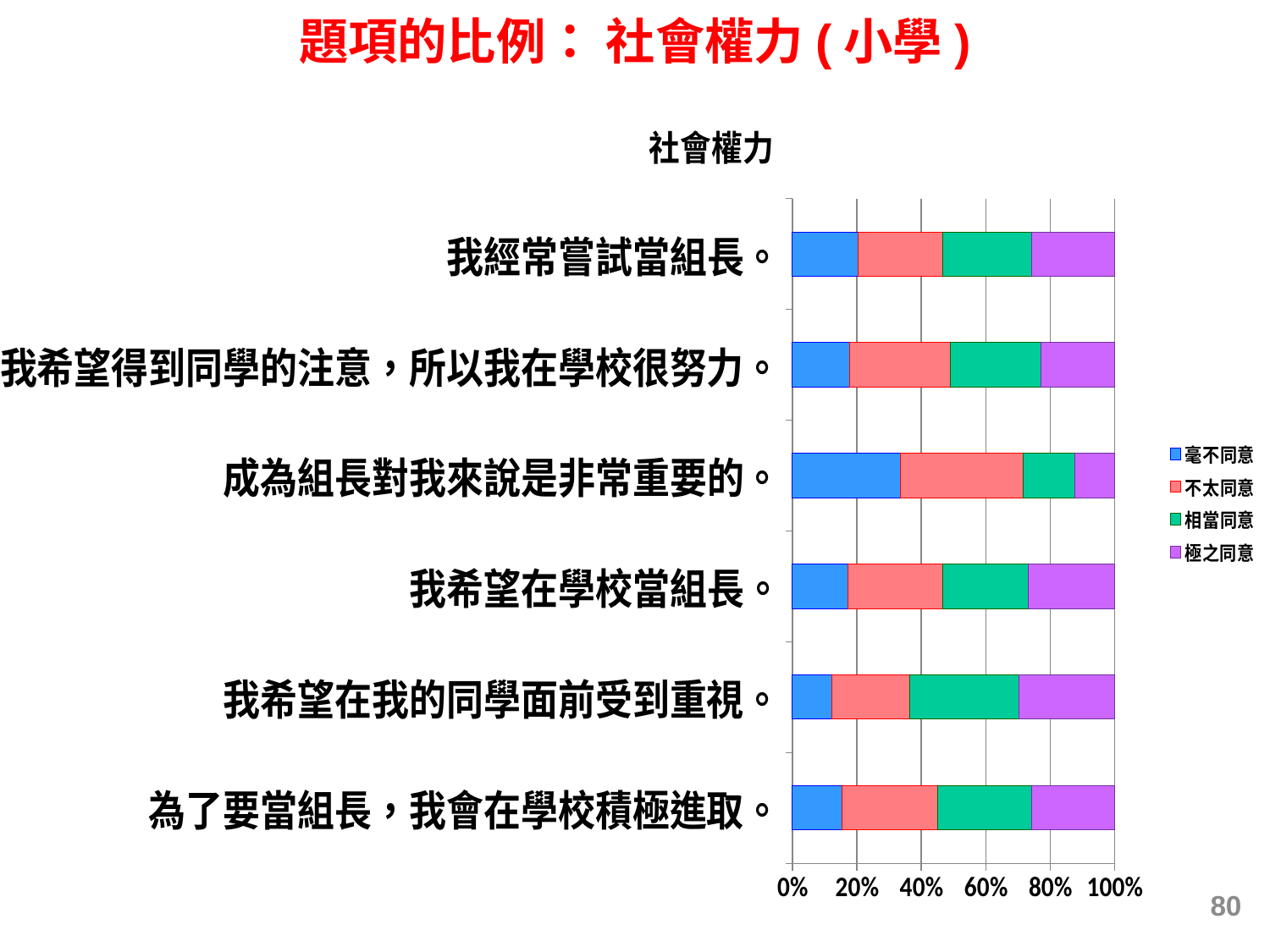
What is the title of the chart? 社會權力 Which has the larger 毫不同意 share: 成為組長對我來說是非常重要的。 or 我經常嘗試當組長。? 成為組長對我來說是非常重要的。 Which colour represents 相當同意 in the chart? Green What kind of chart is shown on the slide? Stacked bar chart Which statement has the smallest 極之同意 share? 成為組長對我來說是非常重要的。 What does each stacked bar total on the x axis? 100% Is the 毫不同意 share for 成為組長對我來說是非常重要的。 greater or less than 20%? greater Which statement has the largest 毫不同意 share? 成為組長對我來說是非常重要的。 Is the 毫不同意 share for 我希望在我的同學面前受到重視。 greater or less than 20%? less How many statements (categories) are plotted in the chart? 6 Which statement has the smallest 毫不同意 share? 我希望在我的同學面前受到重視。 How many series does the legend list? 4